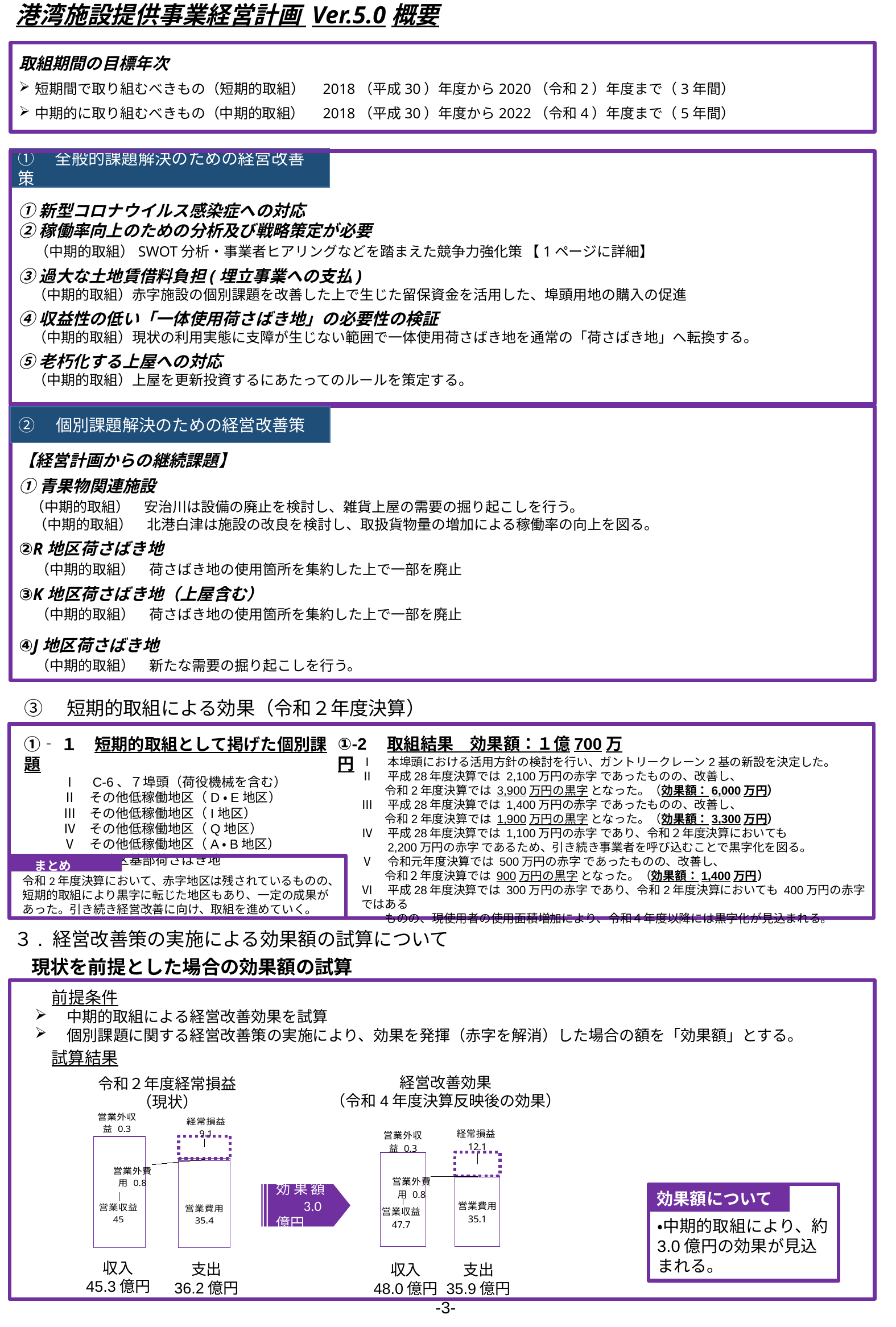
What is the difference in 営業収益 between the right chart (47.7) and the left chart (45)? 2.7 In the right chart (経営改善効果), what is the value of 営業収益? 47.7 In the left chart (令和2年度経常損益（現状）), what is the value of 営業費用? 35.4 What 効果額 is shown in the arrow between the two charts? 3.0億円 In the right chart (経営改善効果), what is the total 支出 shown below the bar? 35.9億円 In the left chart (令和2年度経常損益（現状）), what is the value of 営業収益? 45 What kind of chart is used to show 収入 and 支出 in the 試算結果 section? Stacked bar chart In the left chart (令和2年度経常損益（現状）), what is the total 収入 shown below the bar? 45.3億円 In the right chart (経営改善効果), what is the 経常損益 shown? 12.1 In the right chart (経営改善効果), what is the value of 営業費用? 35.1 Which is larger: 営業費用 in the left chart or 営業費用 in the right chart? Left chart (35.4) In the left chart (令和2年度経常損益（現状）), what is the 経常損益 shown? 9.1